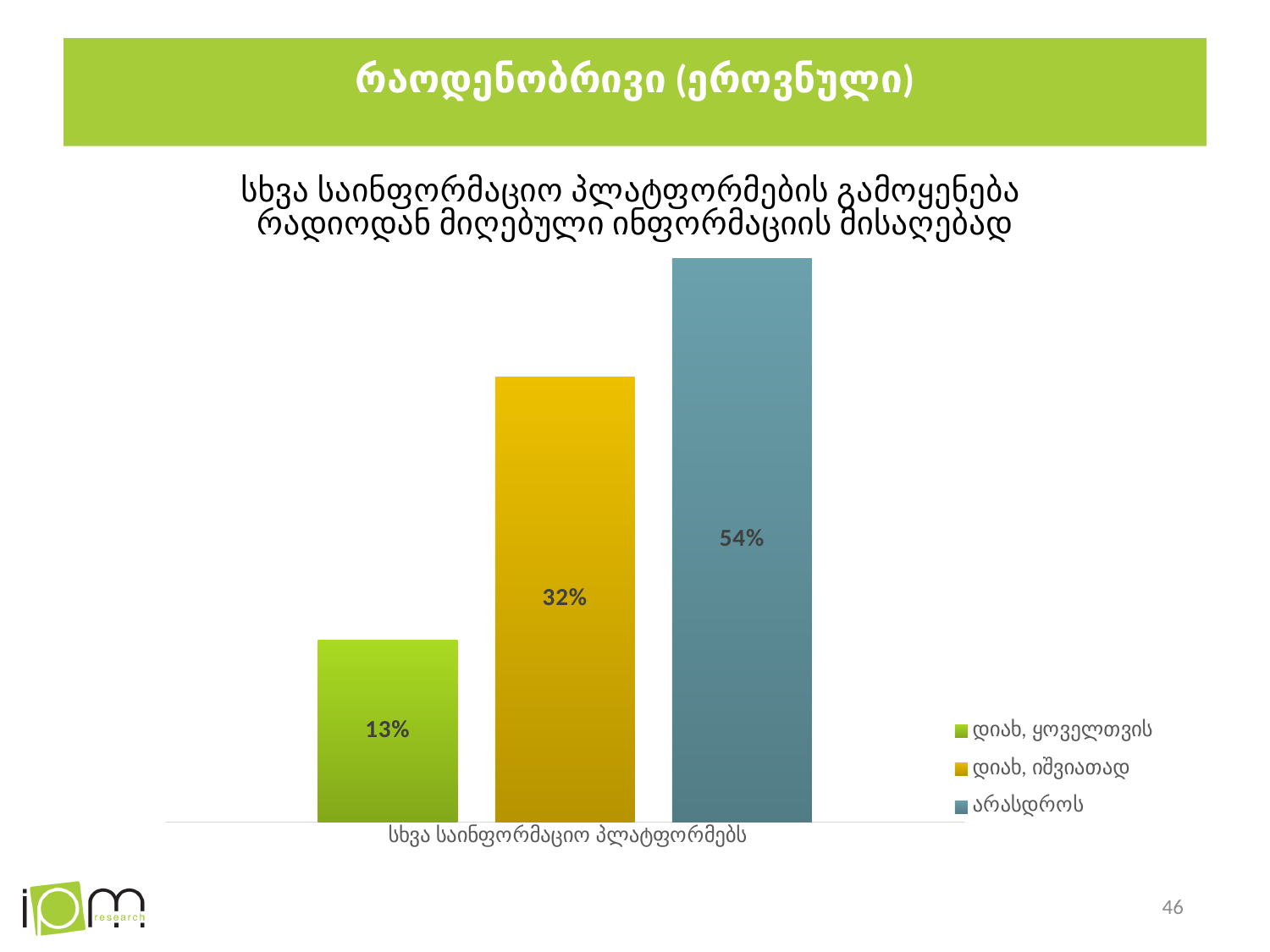
What value is shown for the series "არასდროს"? 54% What is the difference between the values for "არასდროს" and "დიახ, იშვიათად"? 22% Which is larger, the value for "დიახ, იშვიათად" or the value for "დიახ, ყოველთვის"? დიახ, იშვიათად What value is shown for the series "დიახ, ყოველთვის"? 13% What kind of chart is shown on the slide? Bar chart What is the category label shown on the x axis of the chart? სხვა საინფორმაციო პლატფორმებს What is the difference between the values for "დიახ, იშვიათად" and "დიახ, ყოველთვის"? 19% Which series has the lowest value? დიახ, ყოველთვის What value is shown for the series "დიახ, იშვიათად"? 32% Which series has the highest value? არასდროს How many bars are plotted in the chart? 3 How many series does the legend list? 3